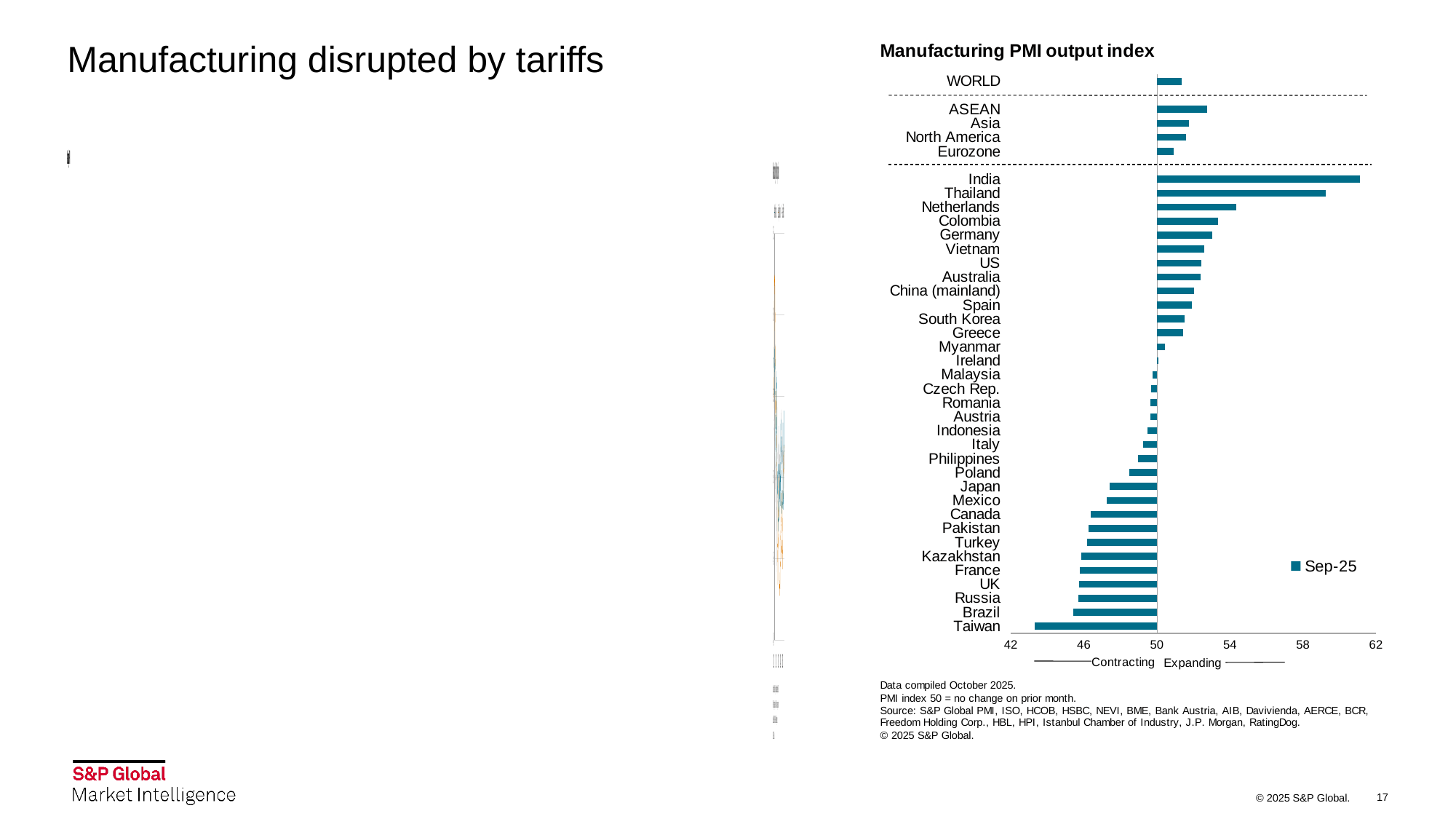
What kind of chart is the 'Manufacturing PMI output index' chart? bar chart In the 'Manufacturing PMI output index' chart, is the value for India greater or less than 58? greater In the 'Manufacturing PMI output index' chart, which country has the lowest PMI output index? Taiwan In the 'Manufacturing PMI output index' chart, how many regional aggregates are shown between the two dashed lines? 4 In the 'Manufacturing PMI output index' chart, how many series does the legend list? 1 In the 'Manufacturing PMI output index' chart, is the value for Brazil greater or less than 50? less In the 'Manufacturing PMI output index' chart, what is the legend entry? Sep-25 In the 'Manufacturing PMI output index' chart, which of the regional aggregates (ASEAN, Asia, North America, Eurozone) has the highest value? ASEAN In the 'Manufacturing PMI output index' chart, which has the larger value, India or Thailand? India In the 'Manufacturing PMI output index' chart, which country has the highest PMI output index? India In the 'Manufacturing PMI output index' chart, is the value for Taiwan greater or less than 46? less